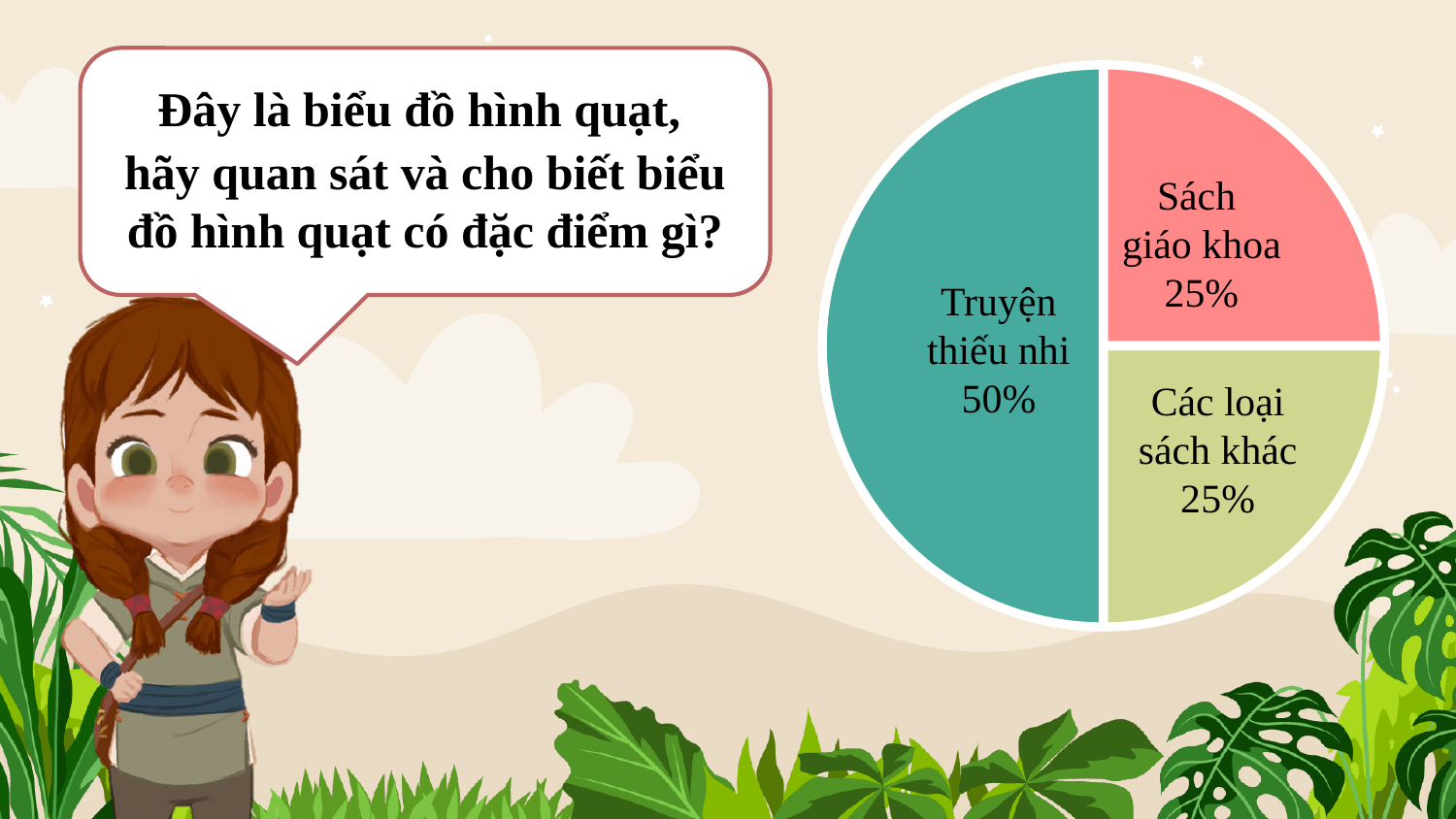
What is the difference between the share for Truyện thiếu nhi and the share for Sách giáo khoa? 25% What share of the pie does Truyện thiếu nhi have? 50% How many slices does the pie chart have? 3 Which category has the largest slice of the pie? Truyện thiếu nhi What is the combined share of Sách giáo khoa and Các loại sách khác? 50% What kind of chart is shown on the slide? pie chart What colour is the Sách giáo khoa slice? pink Which is larger, the share for Truyện thiếu nhi or the share for Các loại sách khác? Truyện thiếu nhi What colour is the Truyện thiếu nhi slice? teal What share of the pie does Các loại sách khác have? 25% What share of the pie does Sách giáo khoa have? 25%